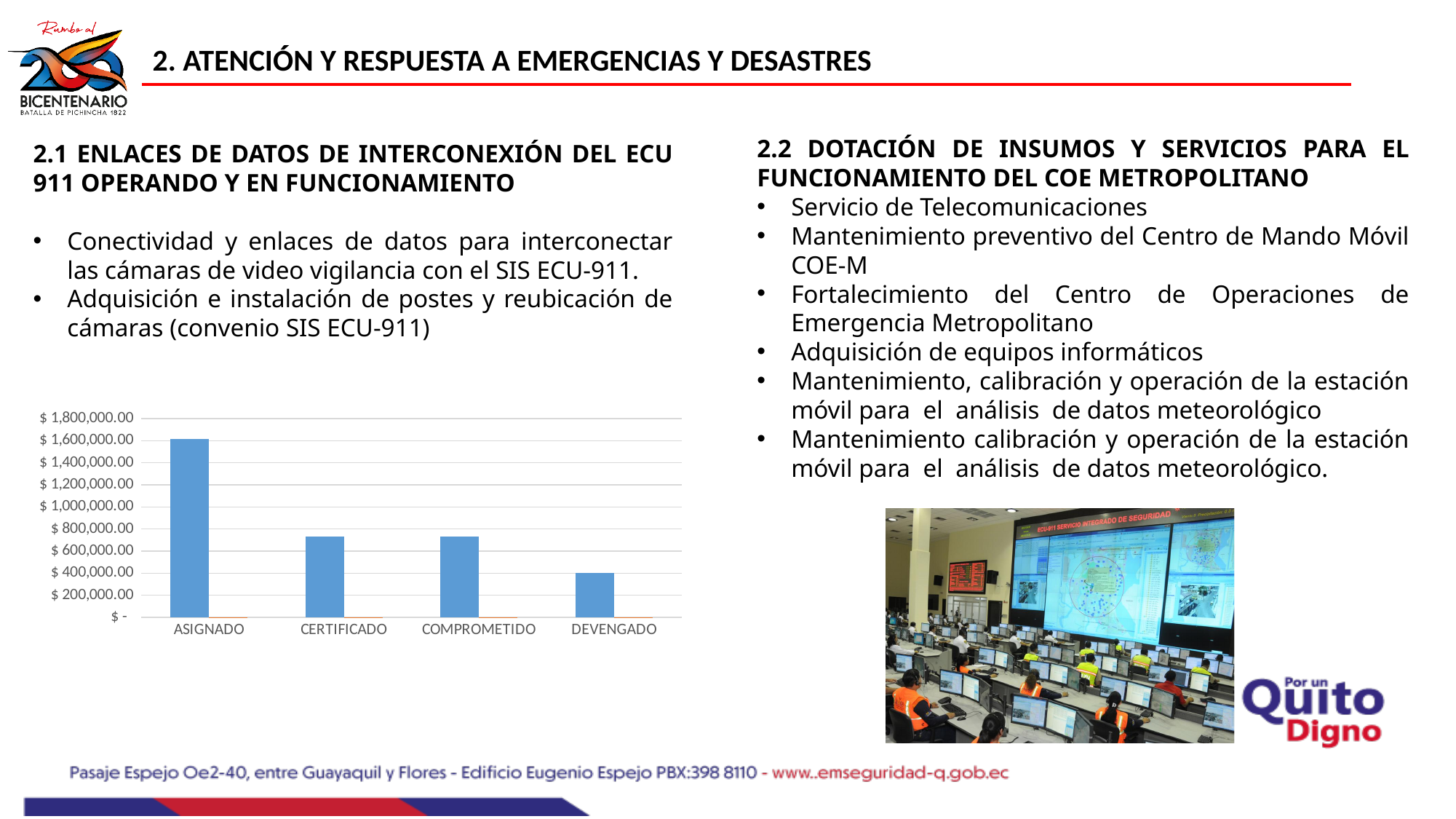
Which is larger, the value for CERTIFICADO or the value for DEVENGADO? CERTIFICADO Is the value for CERTIFICADO greater or less than $ 800,000.00? less Which category has the lowest bar in the chart? DEVENGADO What is the highest tick value shown on the chart's vertical axis? $ 1,800,000.00 Is the value for ASIGNADO greater or less than $ 1,400,000.00? greater Do the bar values generally rise or fall from left to right across the chart? fall Which category has the highest bar in the chart? ASIGNADO Is the value for COMPROMETIDO greater or less than $ 600,000.00? greater Which is larger, the value for ASIGNADO or the value for DEVENGADO? ASIGNADO What kind of chart is shown on the slide? bar chart How many categories are shown on the x axis of the chart? 4